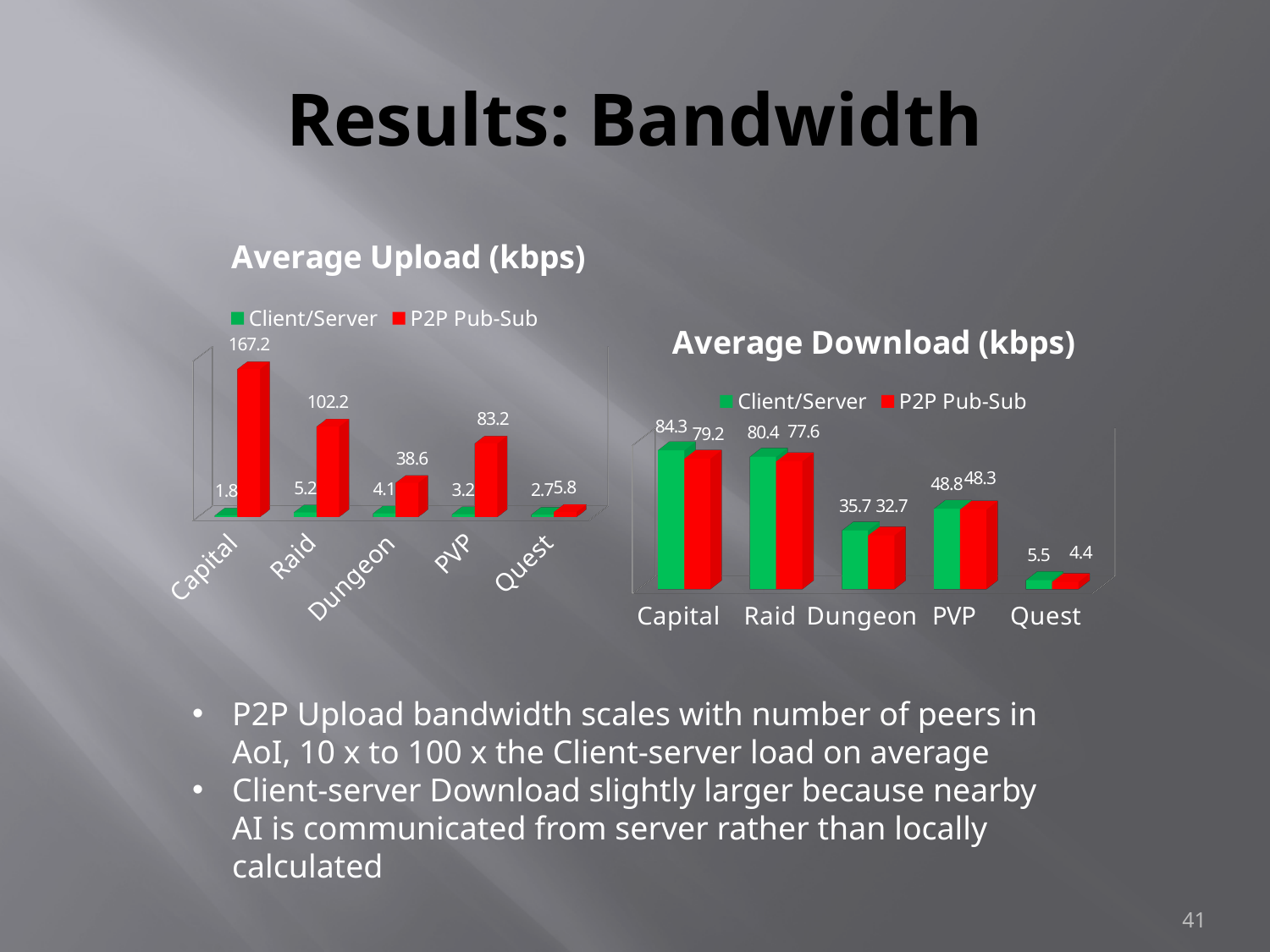
In the Average Upload (kbps) chart, what is the P2P Pub-Sub value for Capital? 167.2 How many categories are shown on the x axis of the Average Download (kbps) chart? 5 In the Average Upload (kbps) chart, which category has the highest P2P Pub-Sub value? Capital In the Average Upload (kbps) chart, what is the difference between the P2P Pub-Sub and Client/Server values for PVP? 80.0 In the Average Upload (kbps) chart, which category has the lowest P2P Pub-Sub value? Quest In the Average Download (kbps) chart, which is larger for Raid: Client/Server or P2P Pub-Sub? Client/Server In the Average Download (kbps) chart, what is the P2P Pub-Sub value for Quest? 4.4 In the Average Download (kbps) chart, what is the Client/Server value for Dungeon? 35.7 In the Average Download (kbps) chart, what is the difference between the Client/Server and P2P Pub-Sub values for Capital? 5.1 In the Average Upload (kbps) chart, what is the Client/Server value for Raid? 5.2 How many series does the legend of the Average Upload (kbps) chart list? 2 In the Average Download (kbps) chart, which category has the highest Client/Server value? Capital